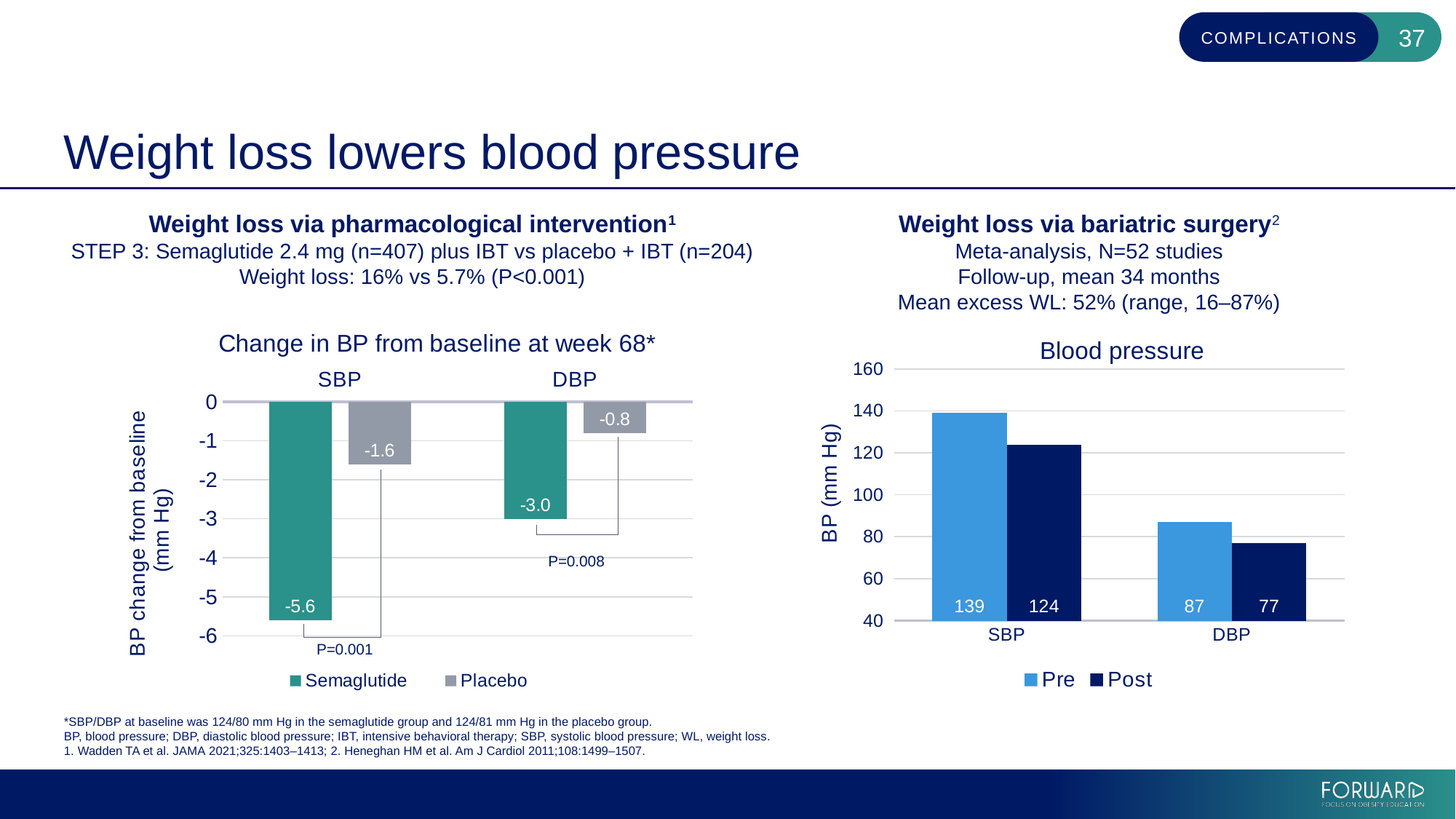
In the 'Blood pressure' chart, what is the difference between the Pre and Post values for SBP? 15 In the 'Change in BP from baseline at week 68*' chart, what is the value for Semaglutide for SBP? -5.6 In the 'Change in BP from baseline at week 68*' chart, what is the difference between the Semaglutide and Placebo values for SBP? 4.0 In the 'Change in BP from baseline at week 68*' chart, which series shows the larger decrease for DBP, Semaglutide or Placebo? Semaglutide In the 'Blood pressure' chart, what is the y-axis label? BP (mm Hg) In the 'Blood pressure' chart, which bar has the lowest value? Post DBP (77) In the 'Change in BP from baseline at week 68*' chart, what is the P value shown for the SBP comparison? P=0.001 In the 'Change in BP from baseline at week 68*' chart, how many series does the legend list? 2 In the 'Blood pressure' chart, what is the Pre value for SBP? 139 In the 'Change in BP from baseline at week 68*' chart, what is the value for Placebo for DBP? -0.8 In the 'Blood pressure' chart, what is the Post value for DBP? 77 In the 'Blood pressure' chart, what kind of chart is shown? Bar chart